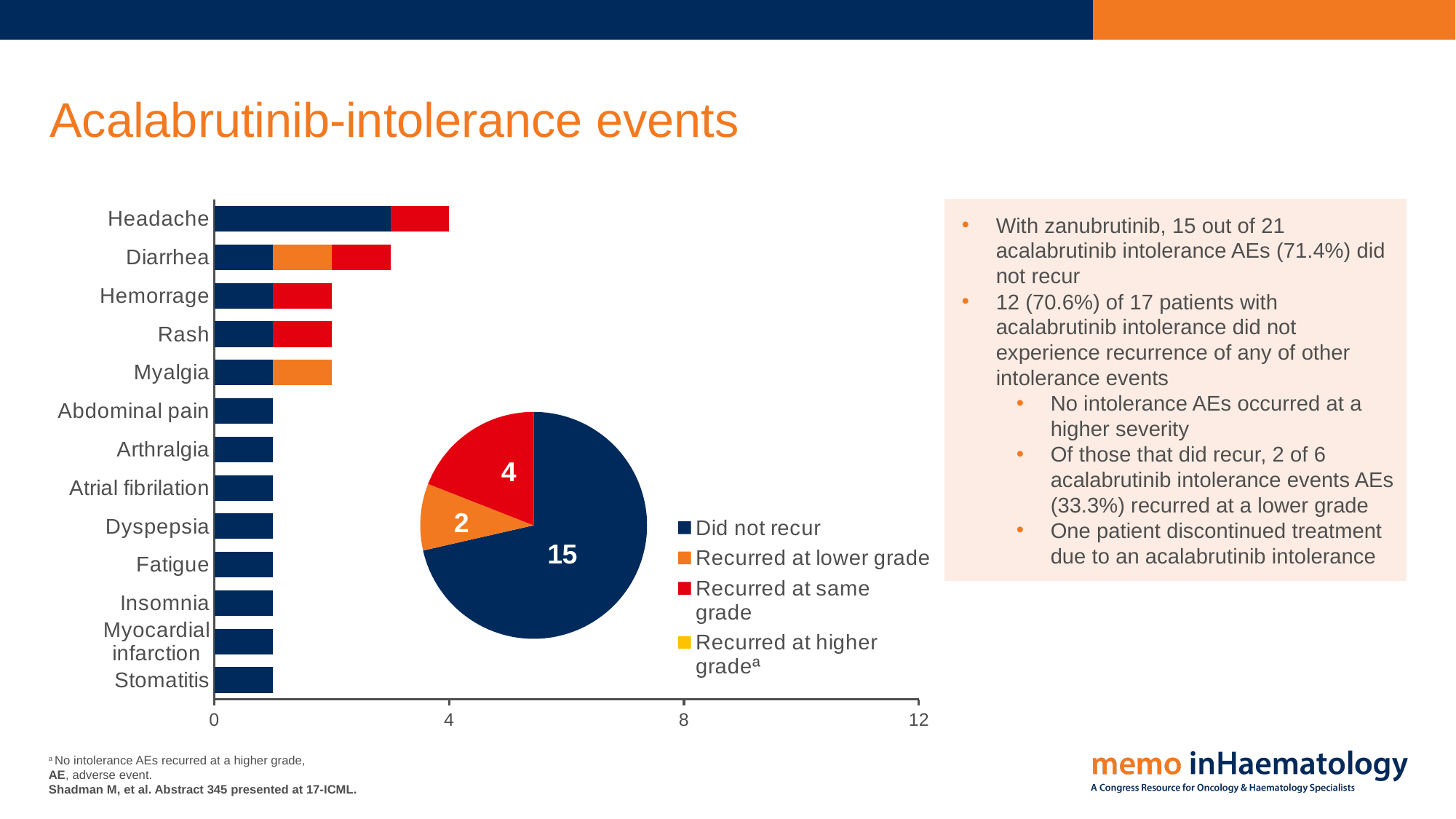
What type of chart is the chart on the left of the slide listing adverse events such as Headache and Diarrhea? bar chart In the pie chart, what is the value for 'Recurred at same grade'? 4 How many entries does the legend of the pie chart list? 4 In the bar chart on the left, is the total value for Stomatitis greater or less than 4? less In the bar chart on the left, which adverse event has the longest bar? Headache In the pie chart, which is larger: 'Recurred at lower grade' or 'Recurred at same grade'? Recurred at same grade In the pie chart, what is the difference between the 'Did not recur' value and the 'Recurred at same grade' value? 11 In the bar chart on the left, is the total value for Diarrhea greater or less than 4? less What type of chart is the chart in the centre of the slide with the values 15, 2 and 4? pie chart In the bar chart on the left, how many adverse event categories are listed on the vertical axis? 13 In the pie chart, what is the value for 'Did not recur'? 15 In the bar chart on the left, what is the total length of the Headache bar? 4